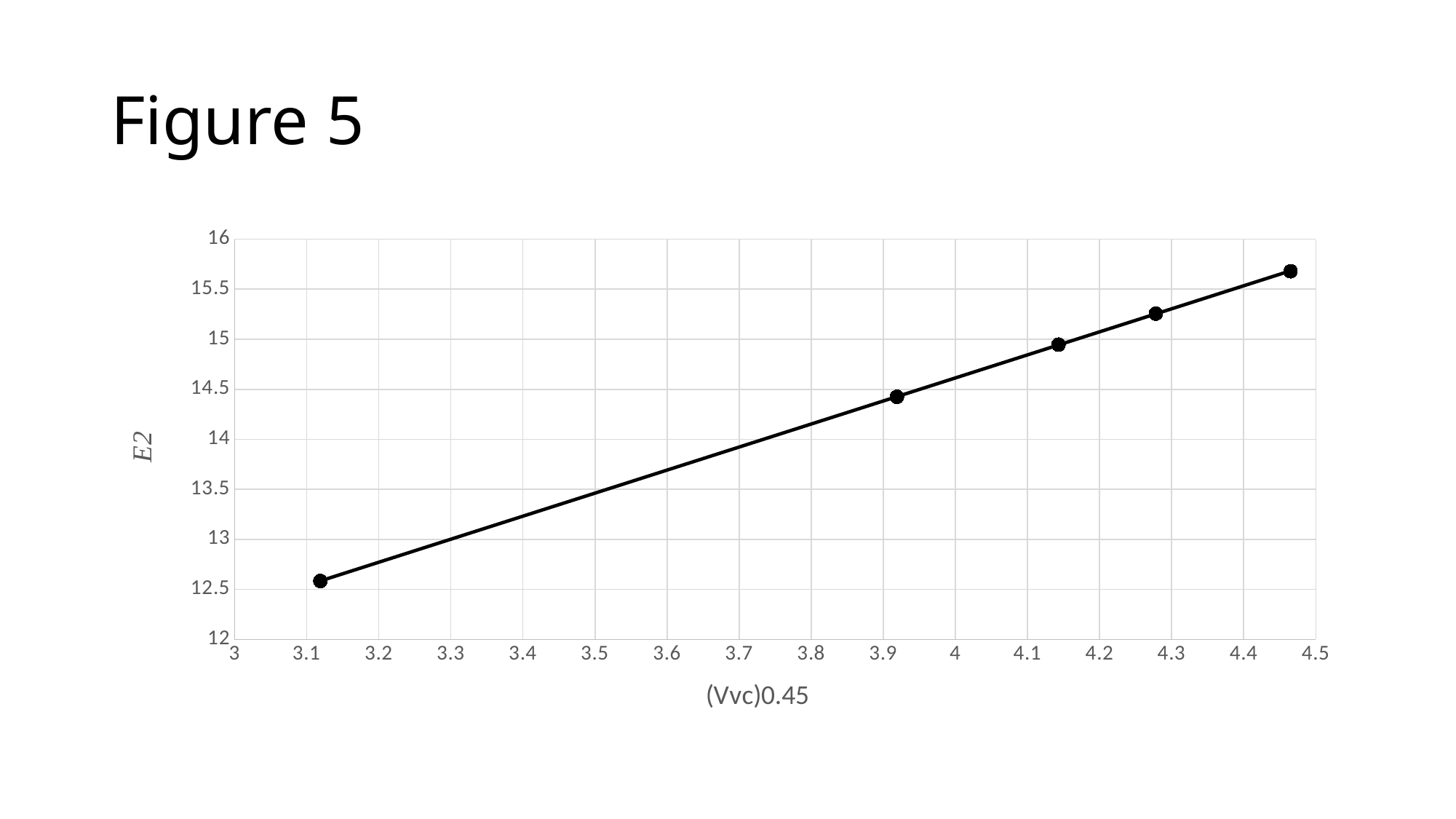
What is the label of the y axis? E2 What is the label of the x axis? (Vvc)0.45 Is the E2 value of the leftmost data point greater or less than 13? less Is the E2 value of the rightmost data point greater or less than 15.5? greater Is the E2 value of the leftmost data point greater or less than 12? greater Which data point has the lowest E2 value, the leftmost or the rightmost? the leftmost Which data point has the highest E2 value, the leftmost or the rightmost? the rightmost Do the E2 values rise or fall as (Vvc)0.45 increases along the x axis? rise What kind of chart is shown on the slide? line chart How many data points are plotted on the chart? 5